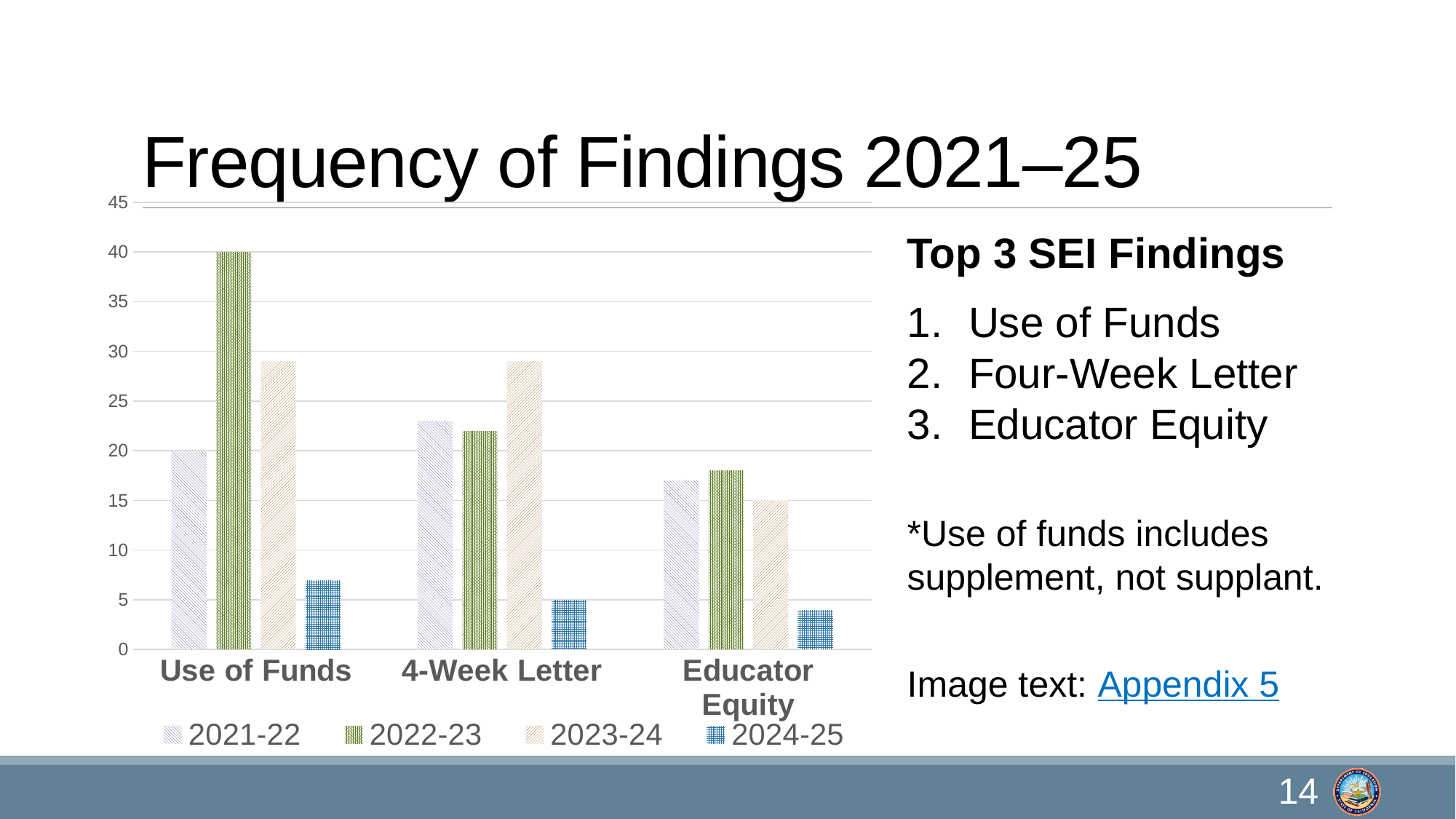
Which category has the lowest 2024-25 value? Educator Equity What is the value for Use of Funds in 2021-22? 20 What is the value for Educator Equity in 2023-24? 15 Is the value for Use of Funds in 2023-24 greater or less than 25? greater Which category has the highest 2022-23 value? Use of Funds How many series does the legend list? 4 What is the value for Use of Funds in 2022-23? 40 Which is larger for 4-Week Letter: the 2021-22 value or the 2023-24 value? 2023-24 What is the title of the chart? Frequency of Findings 2021–25 How many categories are shown on the x axis? 3 What is the value for 4-Week Letter in 2024-25? 5 What type of chart is shown on the slide? bar chart